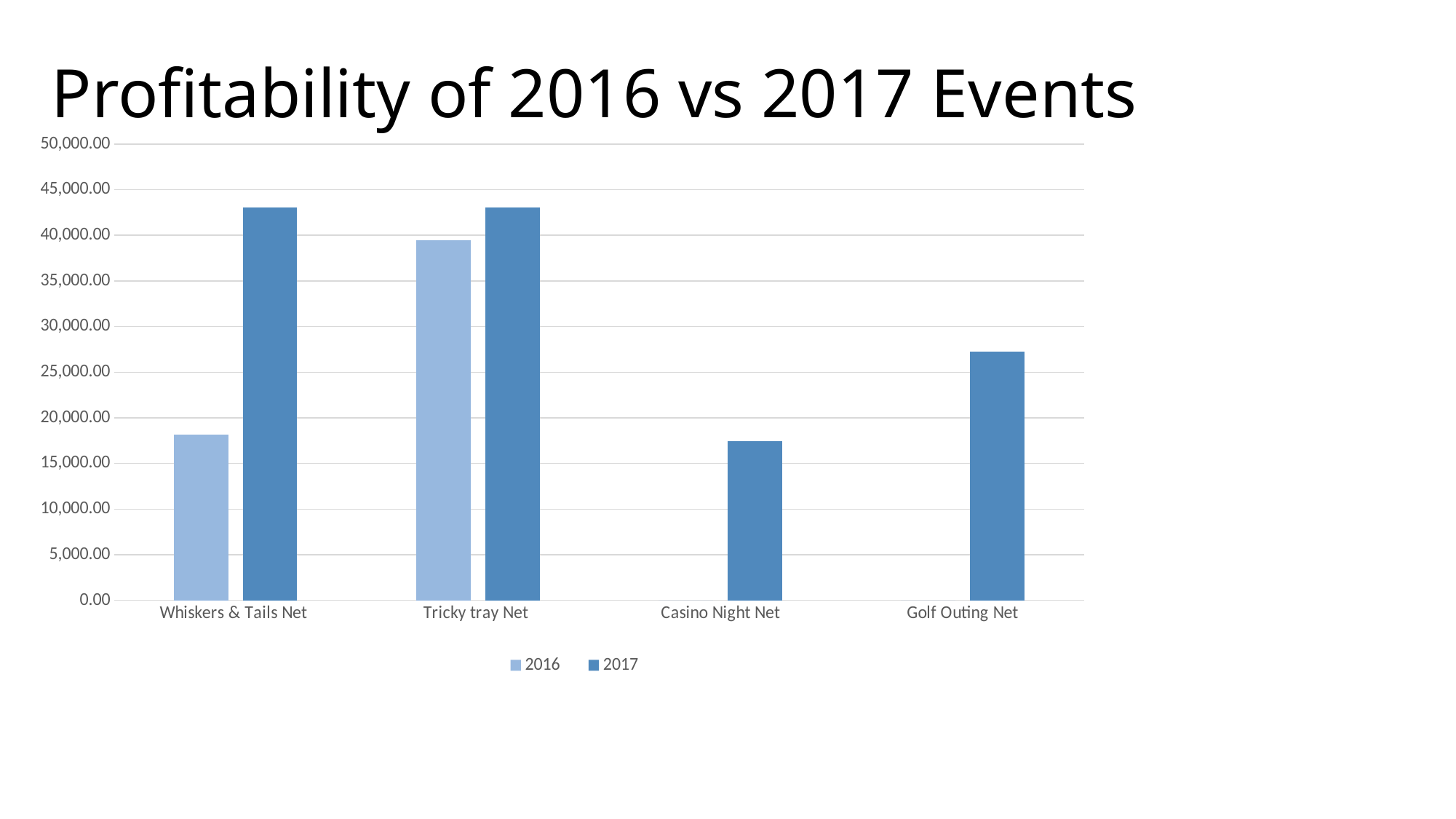
Which series does the legend list first? 2016 Which is larger, the 2017 value for Golf Outing Net or the 2017 value for Casino Night Net? Golf Outing Net What is the title of the slide? Profitability of 2016 vs 2017 Events Is the 2017 value for Golf Outing Net greater or less than 25,000.00? greater Which is larger for Whiskers & Tails Net, the 2016 value or the 2017 value? 2017 How many event categories are shown on the x axis? 4 Is the 2017 value for Casino Night Net greater or less than 20,000.00? less Is the 2017 value for Whiskers & Tails Net greater or less than 40,000.00? greater How many series does the legend list? 2 What kind of chart is shown on the slide? bar chart Which category has the lowest 2017 value? Casino Night Net